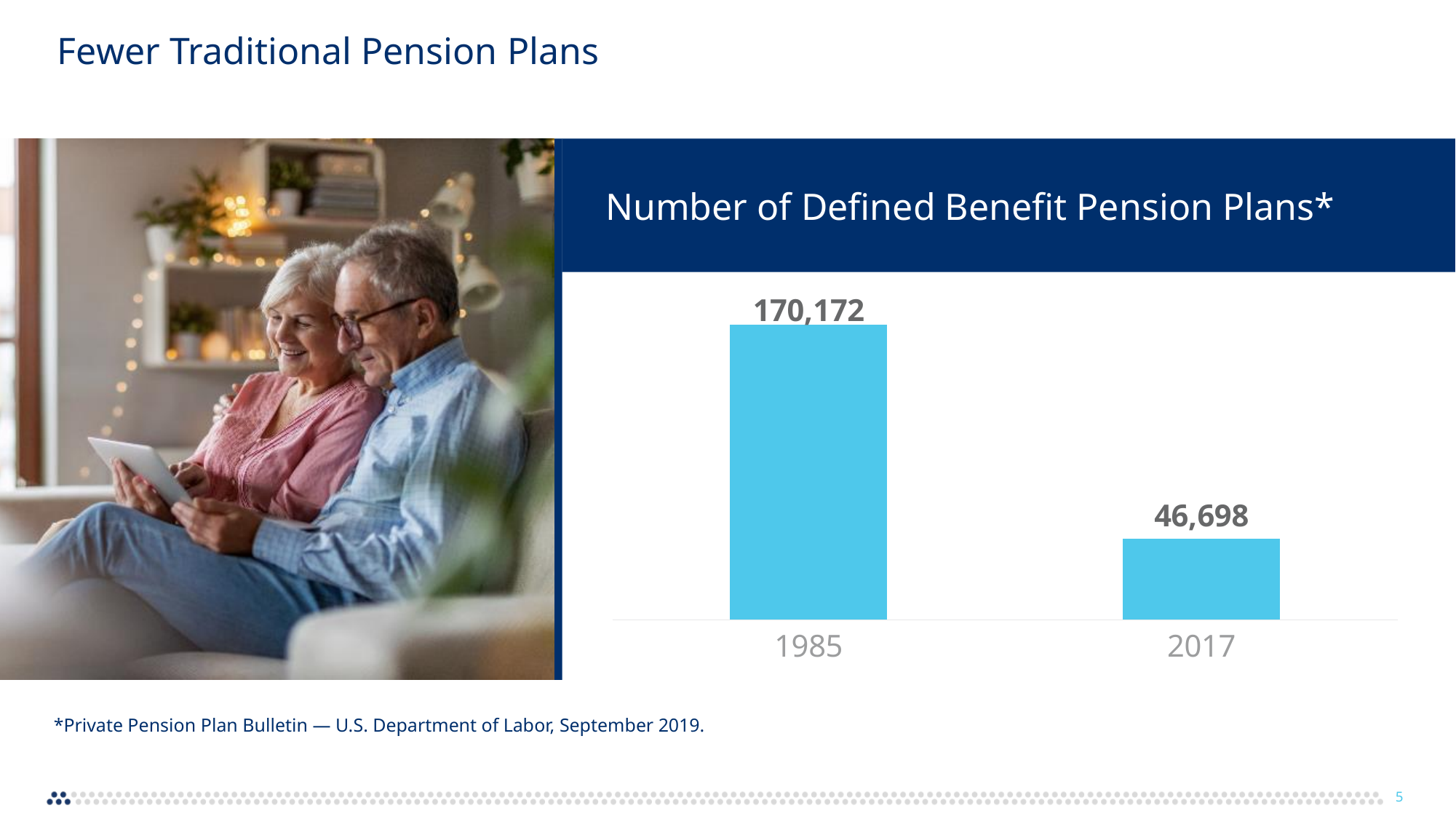
What colour are the bars in the chart? light blue Is the value for 1985 larger or smaller than the value for 2017? larger What is the title of the chart? Number of Defined Benefit Pension Plans* What is the number of defined benefit pension plans shown for 1985? 170,172 Which year has the lower number of defined benefit pension plans? 2017 What is the number of defined benefit pension plans shown for 2017? 46,698 By how much did the number of defined benefit pension plans fall from 1985 to 2017? 123,474 What kind of chart is shown on the slide? bar chart Which year has the higher number of defined benefit pension plans? 1985 How many years (categories) are plotted in the chart? 2 Do the values rise or fall from 1985 to 2017? fall